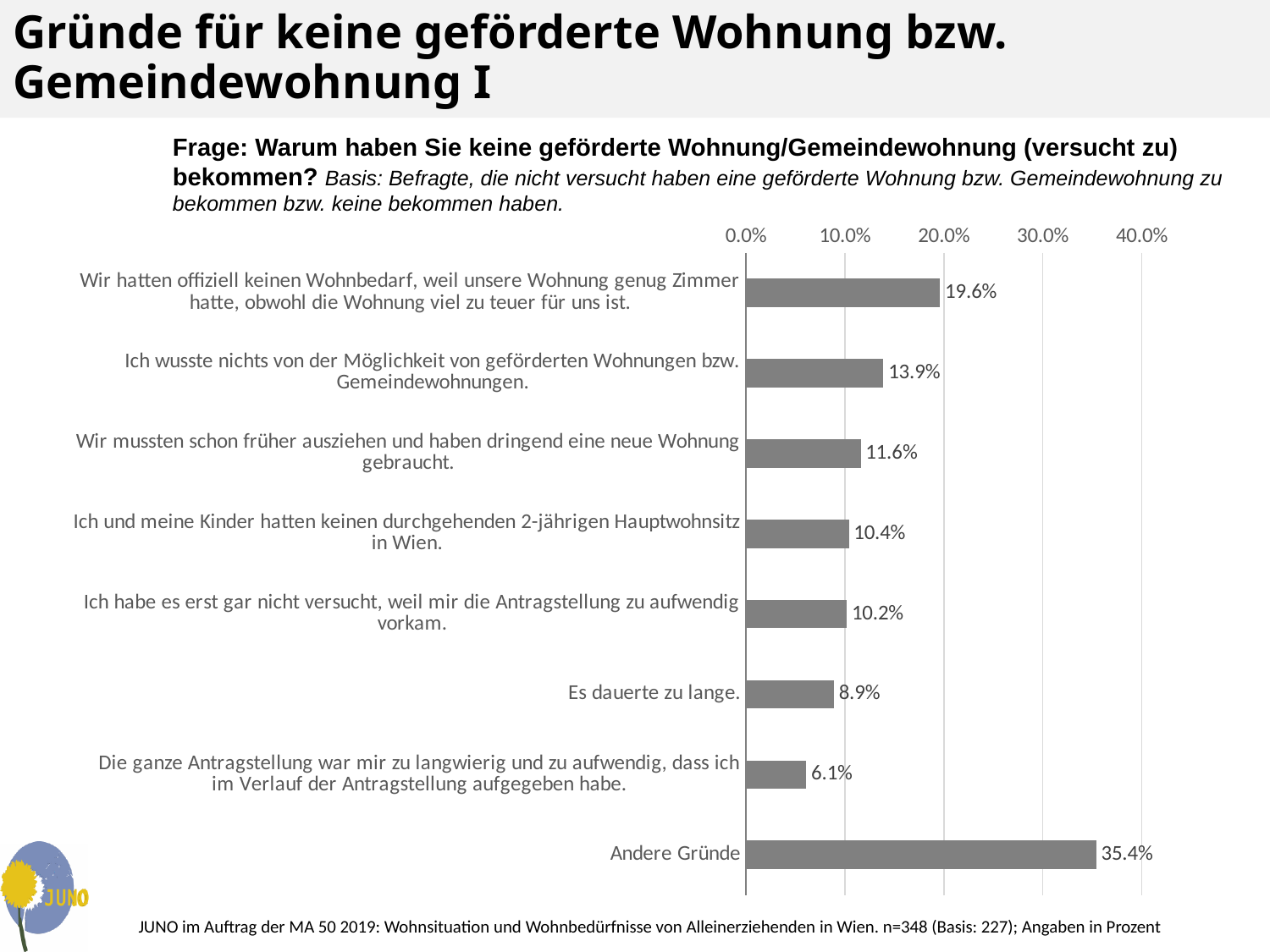
Which category has the lowest value? Die ganze Antragstellung war mir zu langwierig und zu aufwendig, dass ich im Verlauf der Antragstellung aufgegeben habe. What is the value for "Es dauerte zu lange."? 8.9% What is the difference between the value for "Andere Gründe" and the value for "Wir hatten offiziell keinen Wohnbedarf, weil unsere Wohnung genug Zimmer hatte, obwohl die Wohnung viel zu teuer für uns ist."? 15.8% What is the highest value shown on the x axis? 40.0% What is the value for "Andere Gründe"? 35.4% How many categories are shown in the chart? 8 Which is larger: the value for "Wir mussten schon früher ausziehen und haben dringend eine neue Wohnung gebraucht." or the value for "Es dauerte zu lange."? Wir mussten schon früher ausziehen und haben dringend eine neue Wohnung gebraucht. What is the difference between the value for "Ich habe es erst gar nicht versucht, weil mir die Antragstellung zu aufwendig vorkam." and the value for "Die ganze Antragstellung war mir zu langwierig und zu aufwendig, dass ich im Verlauf der Antragstellung aufgegeben habe."? 4.1% Which category has the highest value? Andere Gründe Is the value for "Ich und meine Kinder hatten keinen durchgehenden 2-jährigen Hauptwohnsitz in Wien." greater or less than 10.0%? greater What kind of chart is shown on the slide? bar chart What is the value for "Ich wusste nichts von der Möglichkeit von geförderten Wohnungen bzw. Gemeindewohnungen."? 13.9%